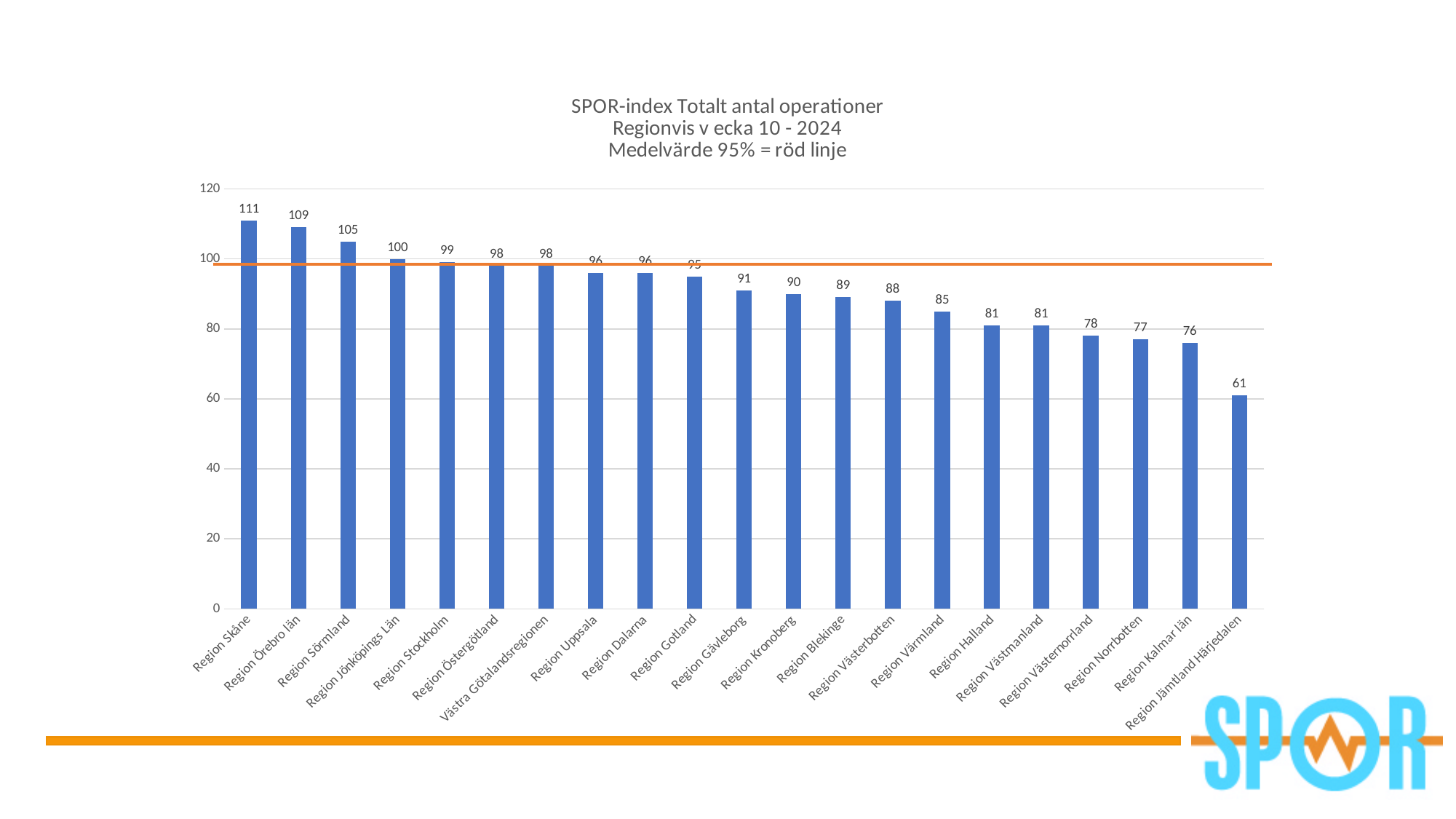
What is the value for Region Jämtland Härjedalen? 61 Which region has the lowest value? Region Jämtland Härjedalen What is the value for Region Gotland? 95 Which has a larger value, Region Örebro län or Region Kalmar län? Region Örebro län What is the value for Region Skåne? 111 What kind of chart is this? Bar chart What is the difference between the values for Region Skåne and Region Jämtland Härjedalen? 50 How many regions are shown on the chart? 21 What is the value for Region Västerbotten? 88 Do the values rise or fall from left to right along the x axis? Fall What is the difference between the values for Region Sörmland and Region Kronoberg? 15 Which region has the highest value? Region Skåne